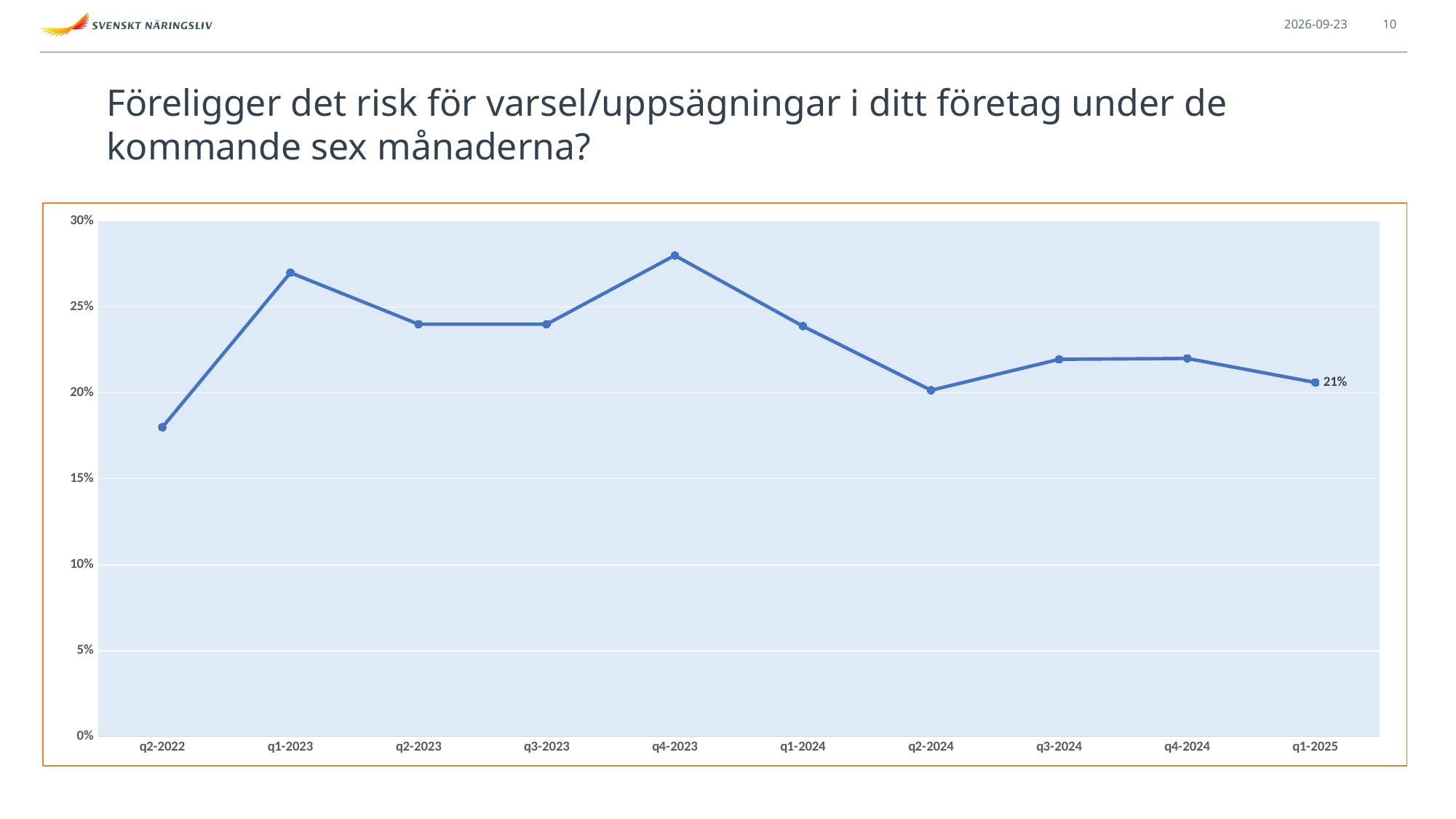
Which quarter has the highest value? q4-2023 Is the value for q3-2024 greater or less than 25%? less Which is larger, the value for q4-2023 or the value for q2-2024? q4-2023 What is the highest value shown on the y axis? 30% What kind of chart is shown on the slide? line chart Which is larger, the value for q2-2022 or the value for q1-2025? q1-2025 Is the value for q2-2022 greater or less than 20%? less How many quarters are plotted on the x axis? 10 What is the value for q1-2025? 21% Is the value for q1-2023 greater or less than 25%? greater Which quarter has the lowest value? q2-2022 Does the value rise or fall from q4-2023 to q2-2024? fall